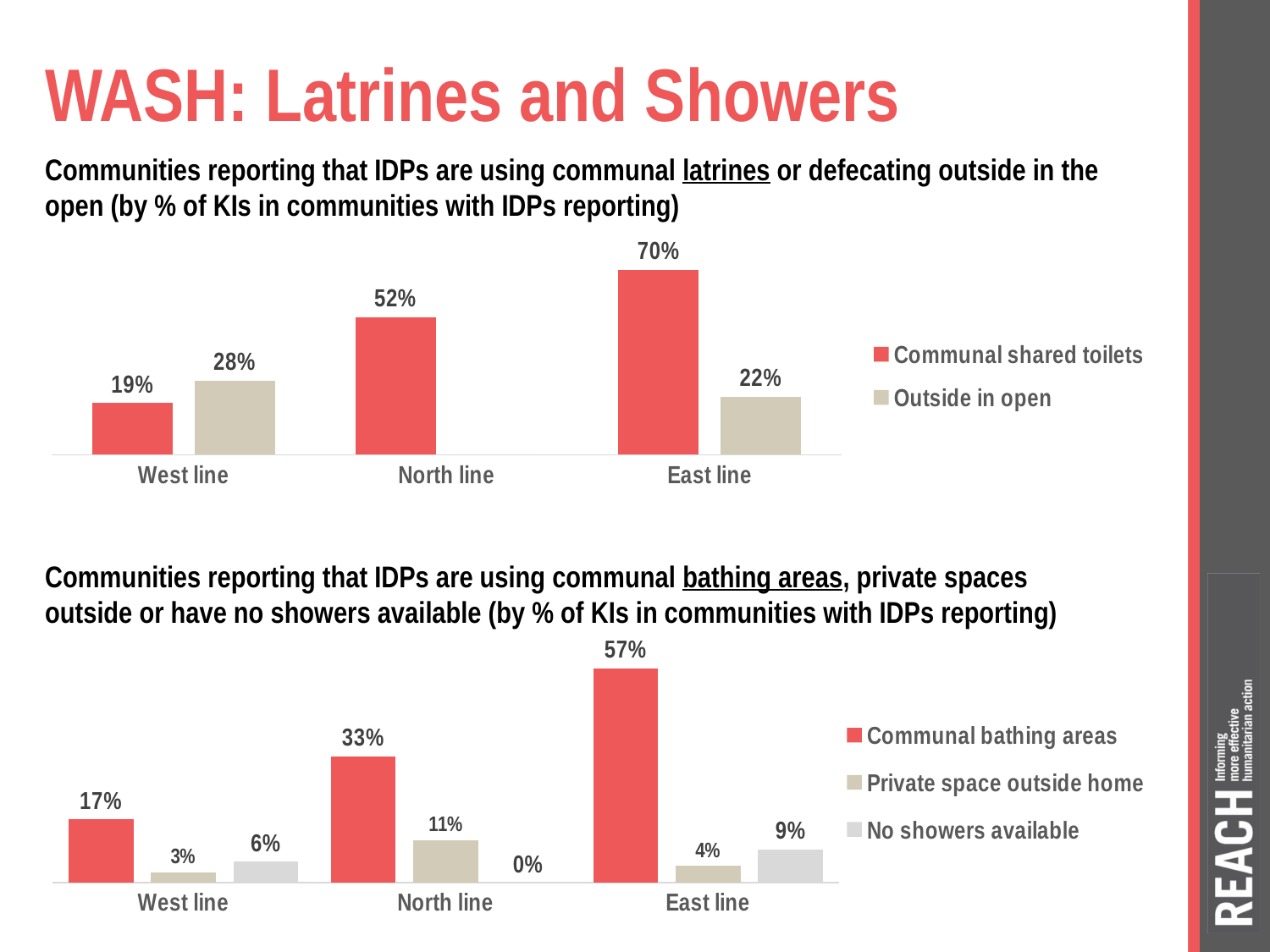
In the bottom chart (bathing areas), which line has the lowest value for Private space outside home? West line What type of chart is the bottom chart (bathing areas)? Bar chart In the top chart (latrines), for West line, which is larger: Communal shared toilets or Outside in open? Outside in open In the top chart (latrines), what is the value for Outside in open for West line? 28% In the bottom chart (bathing areas), what is the difference between Communal bathing areas for East line and West line? 40% In the top chart (latrines), which line has the highest value for Communal shared toilets? East line In the top chart (latrines), what is the difference between Communal shared toilets and Outside in open for East line? 48% In the bottom chart (bathing areas), what is the value for Communal bathing areas for North line? 33% How many series does the legend of the bottom chart (bathing areas) list? 3 In the top chart (latrines), what percentage of KIs in East line communities reported IDPs using communal shared toilets? 70% In the bottom chart (bathing areas), what is the value for No showers available for North line? 0% How many series does the legend of the top chart (latrines) list? 2